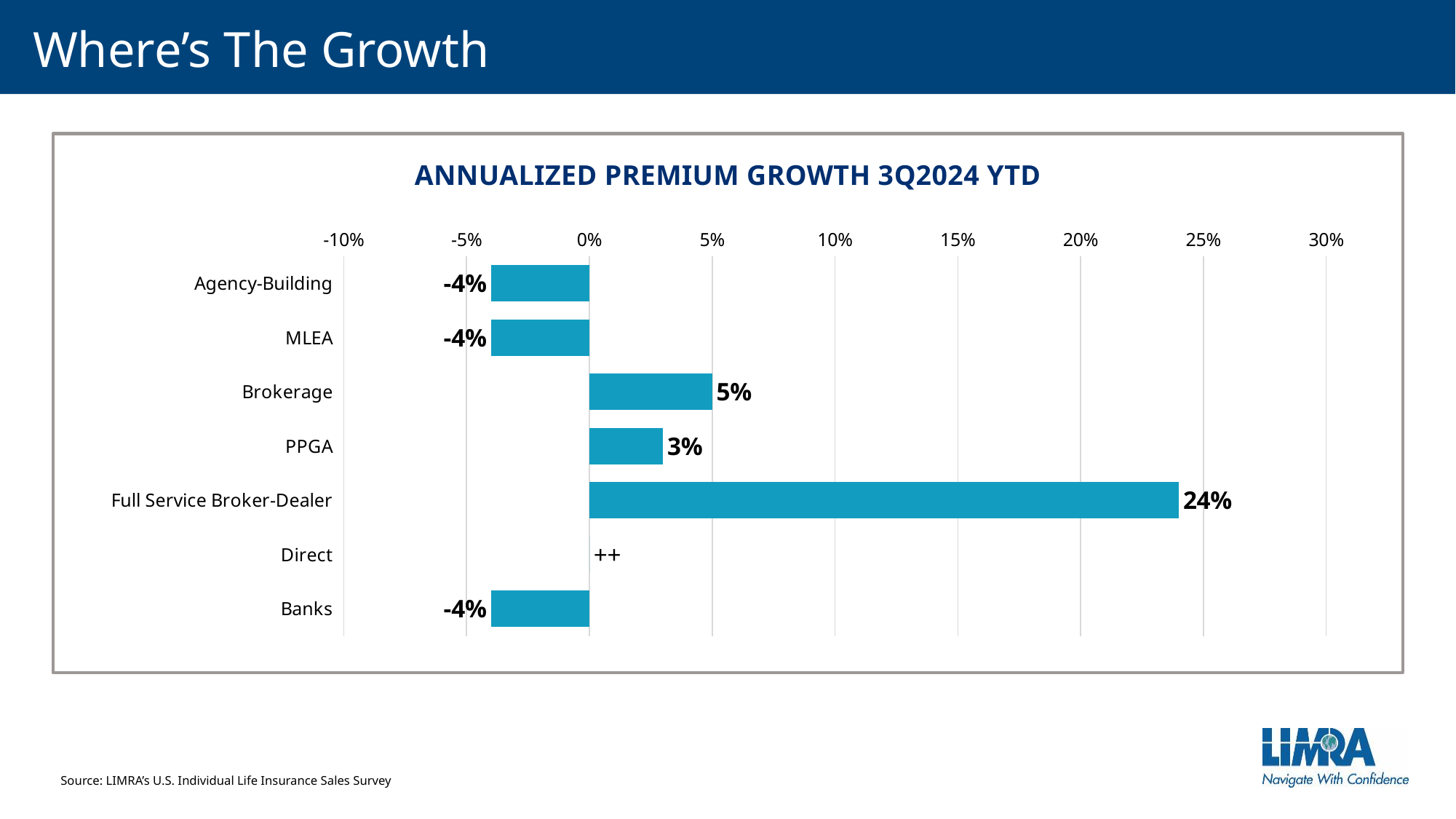
Which has higher annualized premium growth, Brokerage or PPGA? Brokerage What is the difference between the growth for Brokerage and PPGA? 2 percentage points What is the difference between the growth for Full Service Broker-Dealer and Brokerage? 19 percentage points What is the annualized premium growth for MLEA? -4% What is the annualized premium growth for Banks? -4% What is the annualized premium growth for PPGA? 3% What is the annualized premium growth for Brokerage? 5% Is the value for Full Service Broker-Dealer greater or less than 20%? greater Which channel has the highest annualized premium growth? Full Service Broker-Dealer How many channels are listed on the chart? 7 What type of chart is shown on the slide? Bar chart What is the annualized premium growth for Full Service Broker-Dealer? 24%